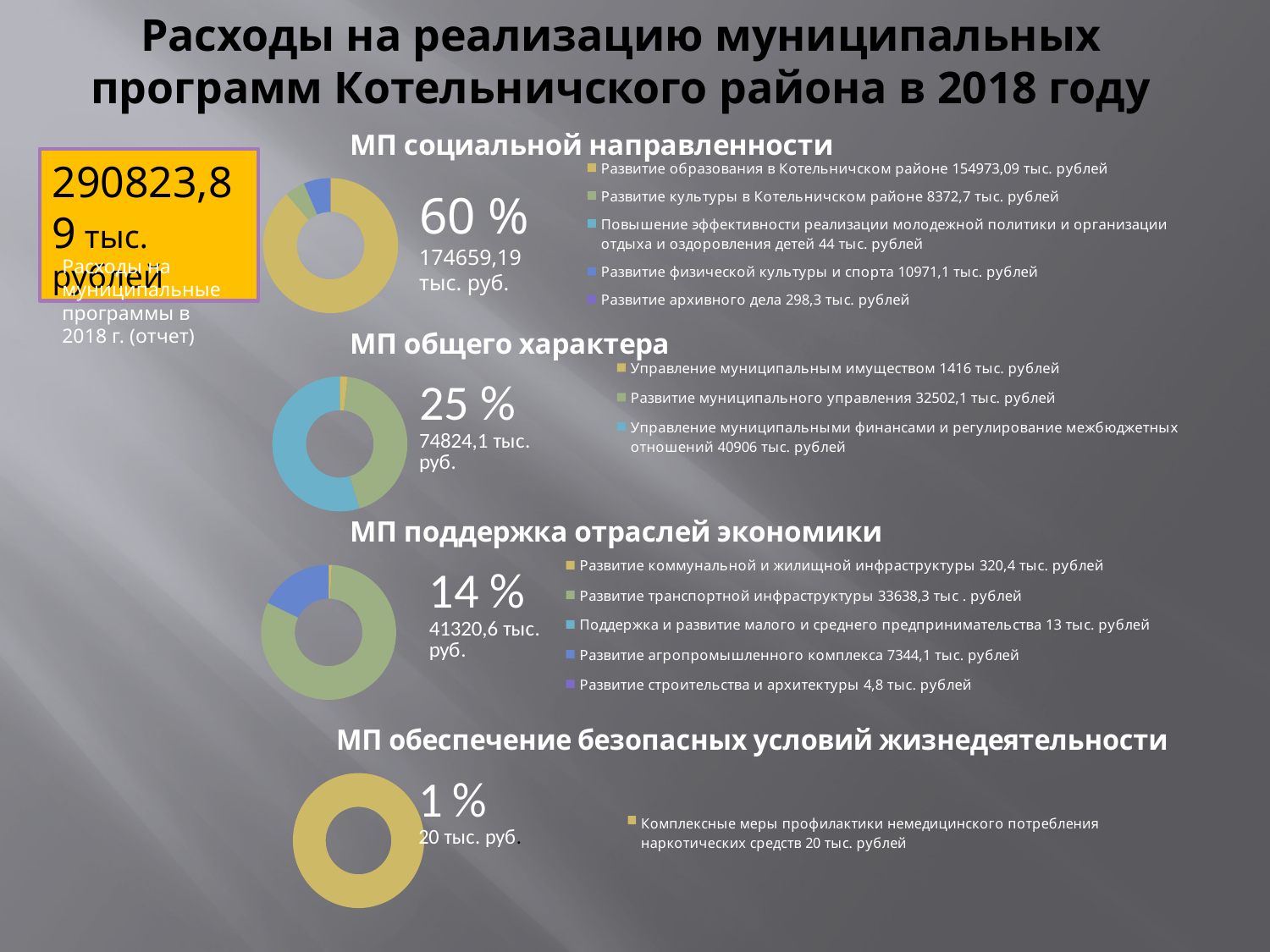
In the "МП поддержка отраслей экономики" chart, what is the value for "Развитие агропромышленного комплекса"? 7344,1 тыс. рублей In the "МП общего характера" chart, which category has the largest value? Управление муниципальными финансами и регулирование межбюджетных отношений What percentage is shown next to the "МП общего характера" chart? 25 % How many categories does the legend of the "МП обеспечение безопасных условий жизнедеятельности" chart list? 1 In the "МП поддержка отраслей экономики" chart, which is larger: "Развитие транспортной инфраструктуры" or "Развитие коммунальной и жилищной инфраструктуры"? Развитие транспортной инфраструктуры In the "МП поддержка отраслей экономики" chart, which category has the smallest value? Развитие строительства и архитектуры In the "МП социальной направленности" chart, which category has the smallest value? Повышение эффективности реализации молодежной политики и организации отдыха и оздоровления детей What total amount is shown next to the "МП социальной направленности" chart? 174659,19 тыс. руб. In the "МП социальной направленности" chart, what is the value for "Развитие образования в Котельничском районе"? 154973,09 тыс. рублей In the "МП социальной направленности" chart, how many categories does the legend list? 5 In the "МП общего характера" chart, what is the difference between "Управление муниципальными финансами и регулирование межбюджетных отношений" and "Развитие муниципального управления"? 8403,9 тыс. рублей What kind of chart is used for "МП социальной направленности"? Donut (pie) chart